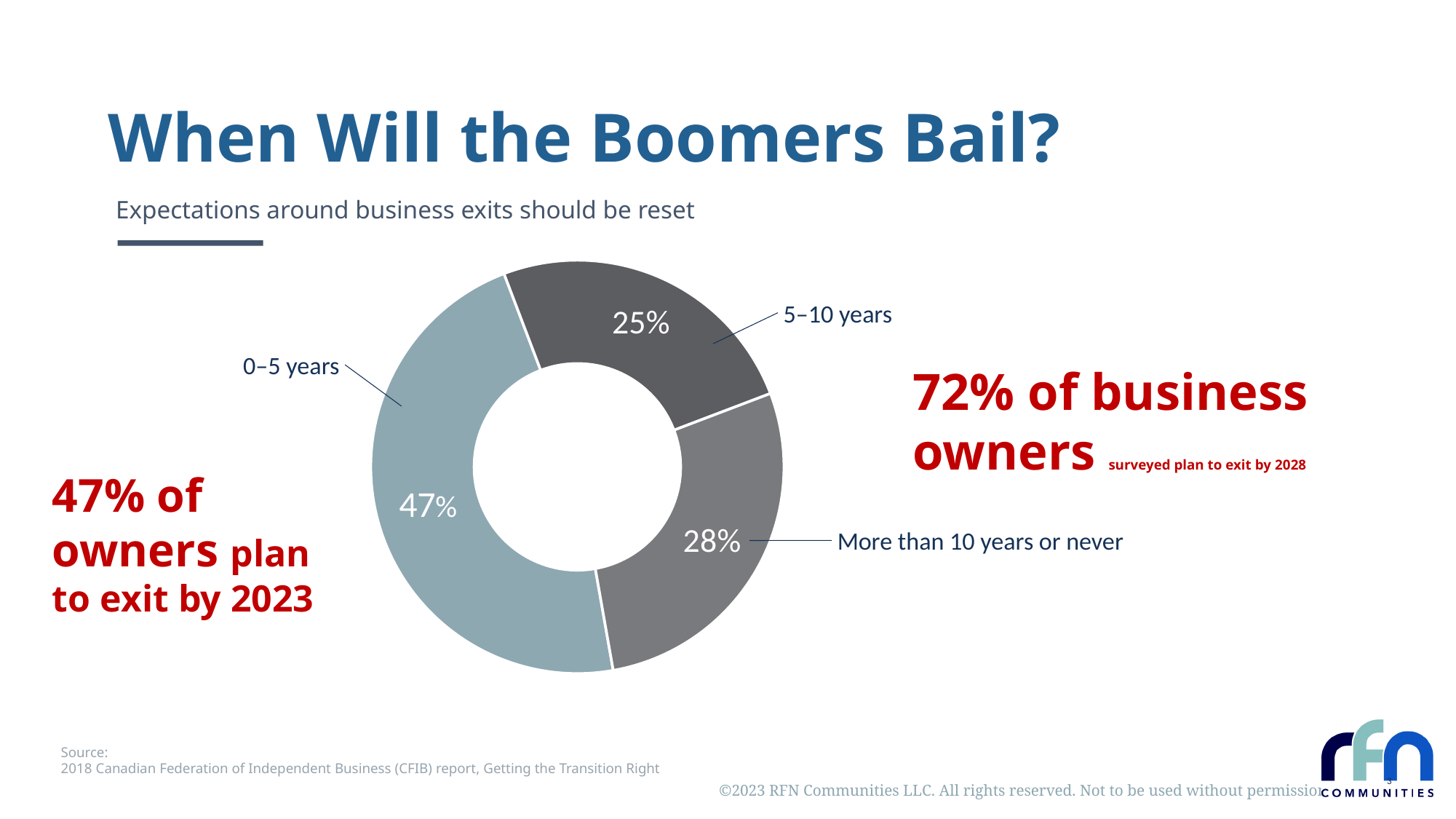
What is the title of the slide containing the chart? When Will the Boomers Bail? What percentage of the doughnut chart is the 'More than 10 years or never' slice? 28% What percentage of the doughnut chart is the 5–10 years slice? 25% What is the difference in percentage points between the 0–5 years slice and the 5–10 years slice? 22 Which category has the smallest share of the doughnut chart? 5–10 years What is the difference in percentage points between the 'More than 10 years or never' slice and the 5–10 years slice? 3 What kind of chart is shown on the slide? Doughnut chart How many categories are shown in the doughnut chart? 3 What is the combined share of the 0–5 years and 5–10 years slices? 72% What percentage of the doughnut chart is the 0–5 years slice? 47% Which is larger: the 0–5 years slice or the 'More than 10 years or never' slice? 0–5 years Which category has the largest share of the doughnut chart? 0–5 years